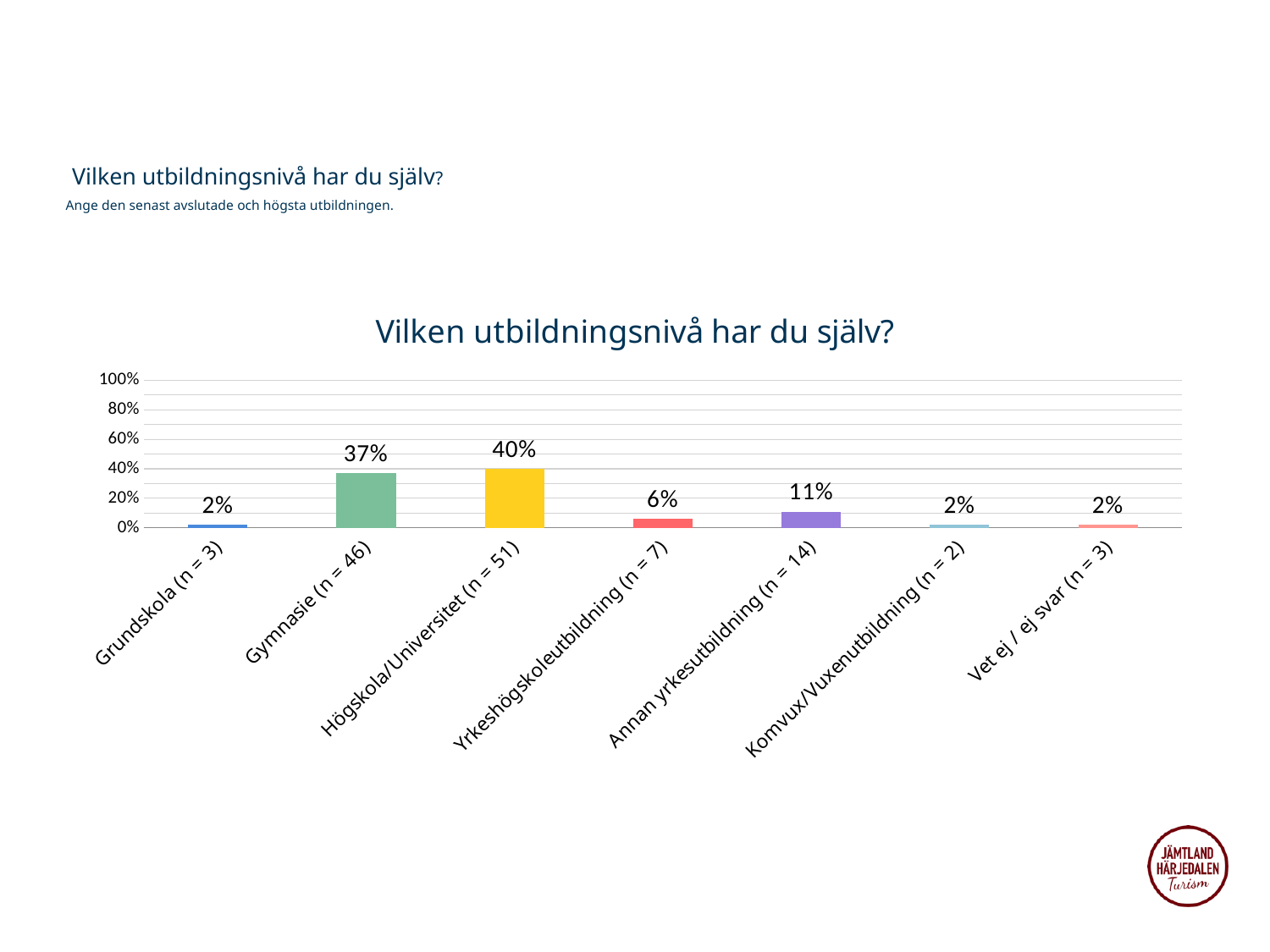
Is the value for Gymnasie (n = 46) greater or less than 20%? greater Which is larger, the value for Annan yrkesutbildning (n = 14) or Yrkeshögskoleutbildning (n = 7)? Annan yrkesutbildning (n = 14) What is the difference between the values for Annan yrkesutbildning (n = 14) and Komvux/Vuxenutbildning (n = 2)? 9% What kind of chart is shown on the slide? bar chart What is the value for Gymnasie (n = 46)? 37% What is the value for Yrkeshögskoleutbildning (n = 7)? 6% Which category has the highest value? Högskola/Universitet (n = 51) What is the title of the chart? Vilken utbildningsnivå har du själv? How many categories are shown on the x axis? 7 What is the value for Högskola/Universitet (n = 51)? 40% What is the difference between the values for Högskola/Universitet (n = 51) and Gymnasie (n = 46)? 3% What is the value for Annan yrkesutbildning (n = 14)? 11%